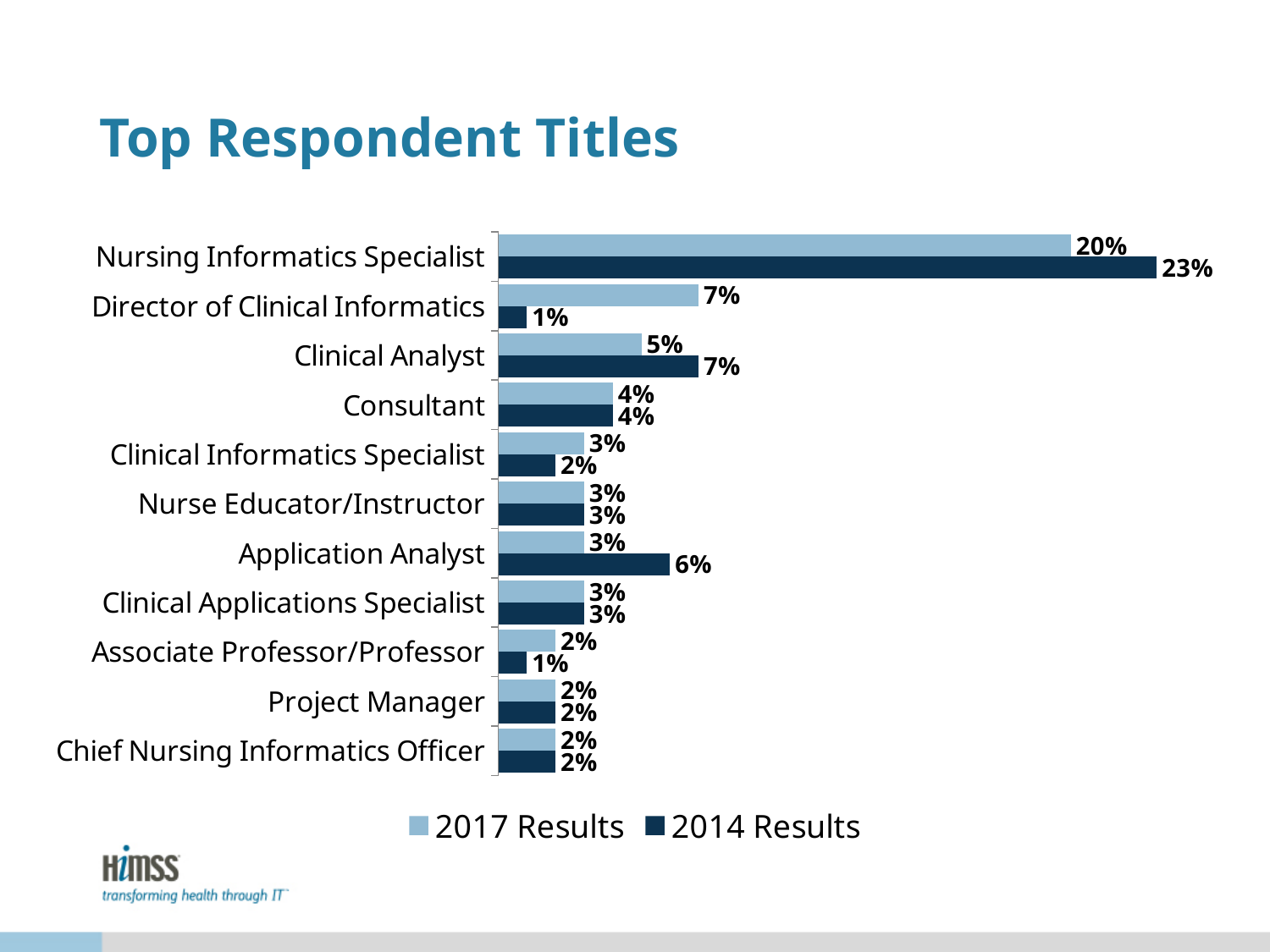
What is the 2014 Results value for Director of Clinical Informatics? 1% What is the 2017 Results value for Nursing Informatics Specialist? 20% For Application Analyst, which is larger: the 2017 Results value or the 2014 Results value? 2014 Results What is the difference between the 2017 Results and 2014 Results values for Director of Clinical Informatics? 6% How many series does the legend list? 2 What is the 2014 Results value for Application Analyst? 6% What is the difference between the 2014 Results and 2017 Results values for Nursing Informatics Specialist? 3% Which title has the highest 2014 Results value? Nursing Informatics Specialist Which title has the highest 2017 Results value? Nursing Informatics Specialist For Clinical Analyst, which is larger: the 2017 Results value or the 2014 Results value? 2014 Results What kind of chart is shown on the slide? Bar chart How many respondent titles are shown on the chart? 11